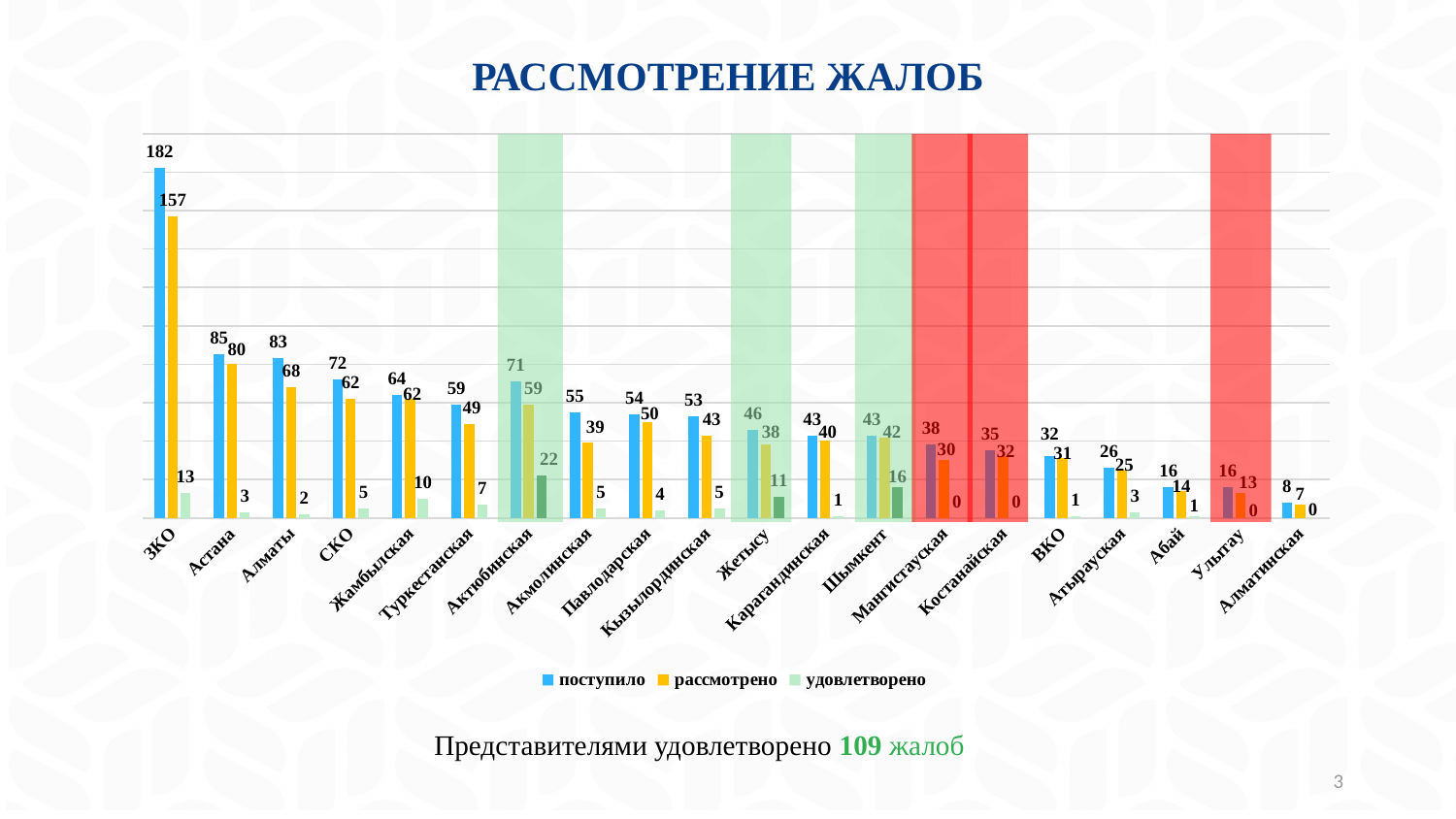
What type of chart is shown on the slide? bar chart Which region has the highest 'поступило' value? ЗКО What is the title of the chart? РАССМОТРЕНИЕ ЖАЛОБ What is the difference between 'поступило' and 'рассмотрено' for ЗКО? 25 Which region has the lowest 'поступило' value? Алматинская What is the difference between 'поступило' for Астана and 'поступило' for Алматы? 2 How many series does the legend list? 3 What is the value of 'поступило' for ЗКО? 182 What is the value of 'удовлетворено' for Шымкент? 16 How many regions (categories) are shown on the x axis? 20 Which is larger: 'удовлетворено' for Актюбинская or for Жетысу? Актюбинская What is the value of 'рассмотрено' for Актюбинская? 59